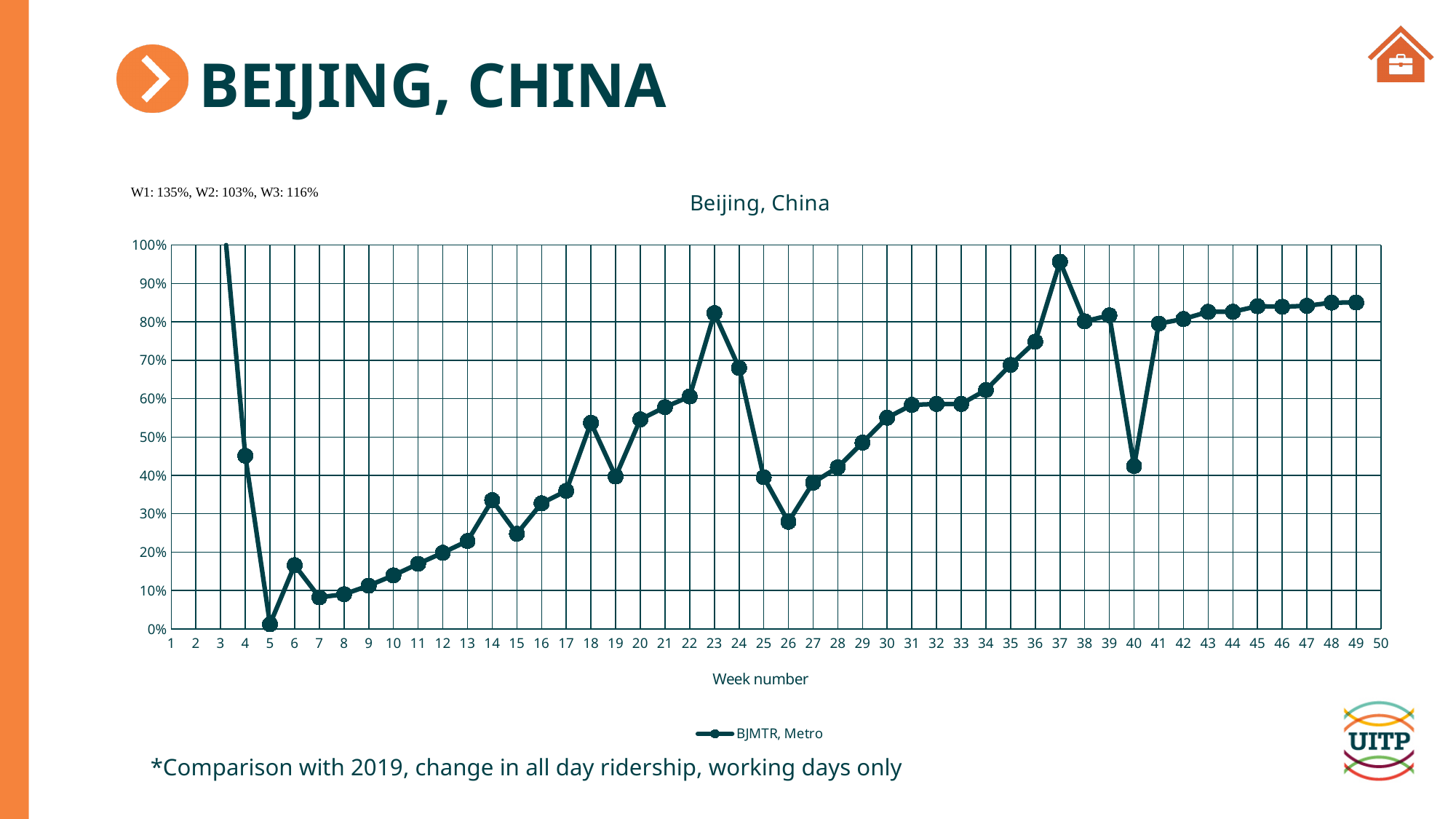
What type of chart is shown on the slide? Line chart What is the difference between the annotated values for W1 and W2? 32 percentage points What is the name of the series shown in the legend? BJMTR, Metro According to the annotation on the slide, what is the value for week 2 (W2)? 103% Which week has the lowest plotted value on the chart? Week 5 According to the annotation on the slide, what is the value for week 1 (W1)? 135% What is the label of the x axis? Week number Is the value for week 26 greater or less than 30%? less Which is larger, the value for week 37 or the value for week 23? Week 37 Of the three annotated weeks W1, W2 and W3, which has the highest value? W1 How many series does the legend list? 1 Is the value for week 37 greater or less than 90%? greater